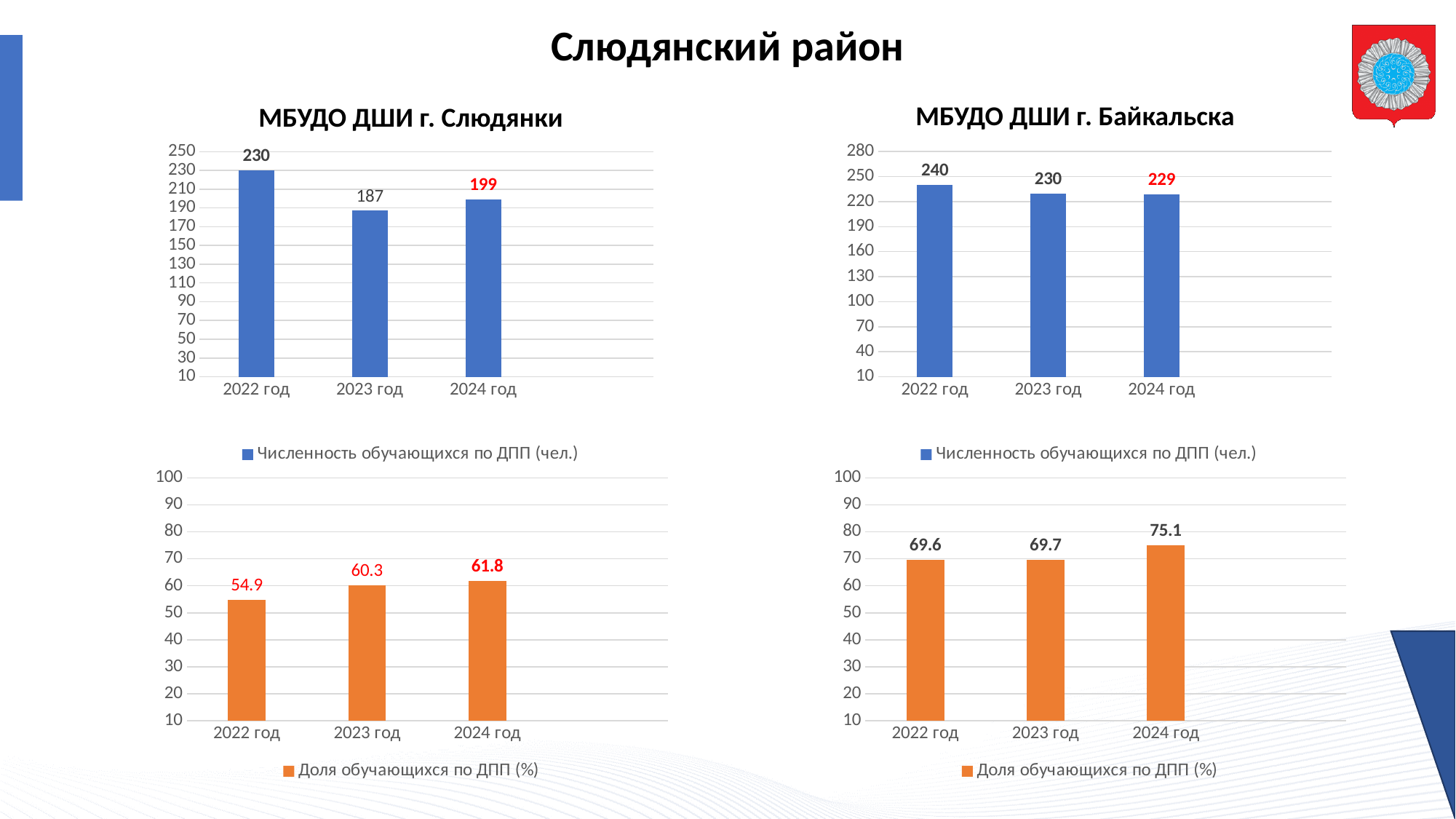
In the top-left chart (МБУДО ДШИ г. Слюдянки, Численность обучающихся по ДПП), which year has the lowest value? 2023 год In the top-right chart (МБУДО ДШИ г. Байкальска, Численность обучающихся по ДПП), which year has the highest value? 2022 год How many categories (years) are shown in the bottom-right chart (Доля обучающихся по ДПП (%) for МБУДО ДШИ г. Байкальска)? 3 In the bottom-right chart (Доля обучающихся по ДПП (%) for МБУДО ДШИ г. Байкальска), what is the value for 2024 год? 75.1 In the bottom-left chart (Доля обучающихся по ДПП (%) for МБУДО ДШИ г. Слюдянки), what is the value for 2023 год? 60.3 In the top-right chart (МБУДО ДШИ г. Байкальска, Численность обучающихся по ДПП), what is the value for 2024 год? 229 In the top-right chart (МБУДО ДШИ г. Байкальска, Численность обучающихся по ДПП), what is the difference between the values for 2022 год and 2023 год? 10 In the top-left chart (МБУДО ДШИ г. Слюдянки, Численность обучающихся по ДПП), what is the value for 2022 год? 230 In the bottom-right chart (Доля обучающихся по ДПП (%) for МБУДО ДШИ г. Байкальска), which is larger, the value for 2022 год or 2024 год? 2024 год In the bottom-left chart (Доля обучающихся по ДПП (%) for МБУДО ДШИ г. Слюдянки), do the values rise or fall from 2022 год to 2024 год? rise What kind of chart is the top-left chart (МБУДО ДШИ г. Слюдянки, Численность обучающихся по ДПП)? bar chart In the top-left chart (МБУДО ДШИ г. Слюдянки, Численность обучающихся по ДПП), what is the difference between the values for 2022 год and 2024 год? 31